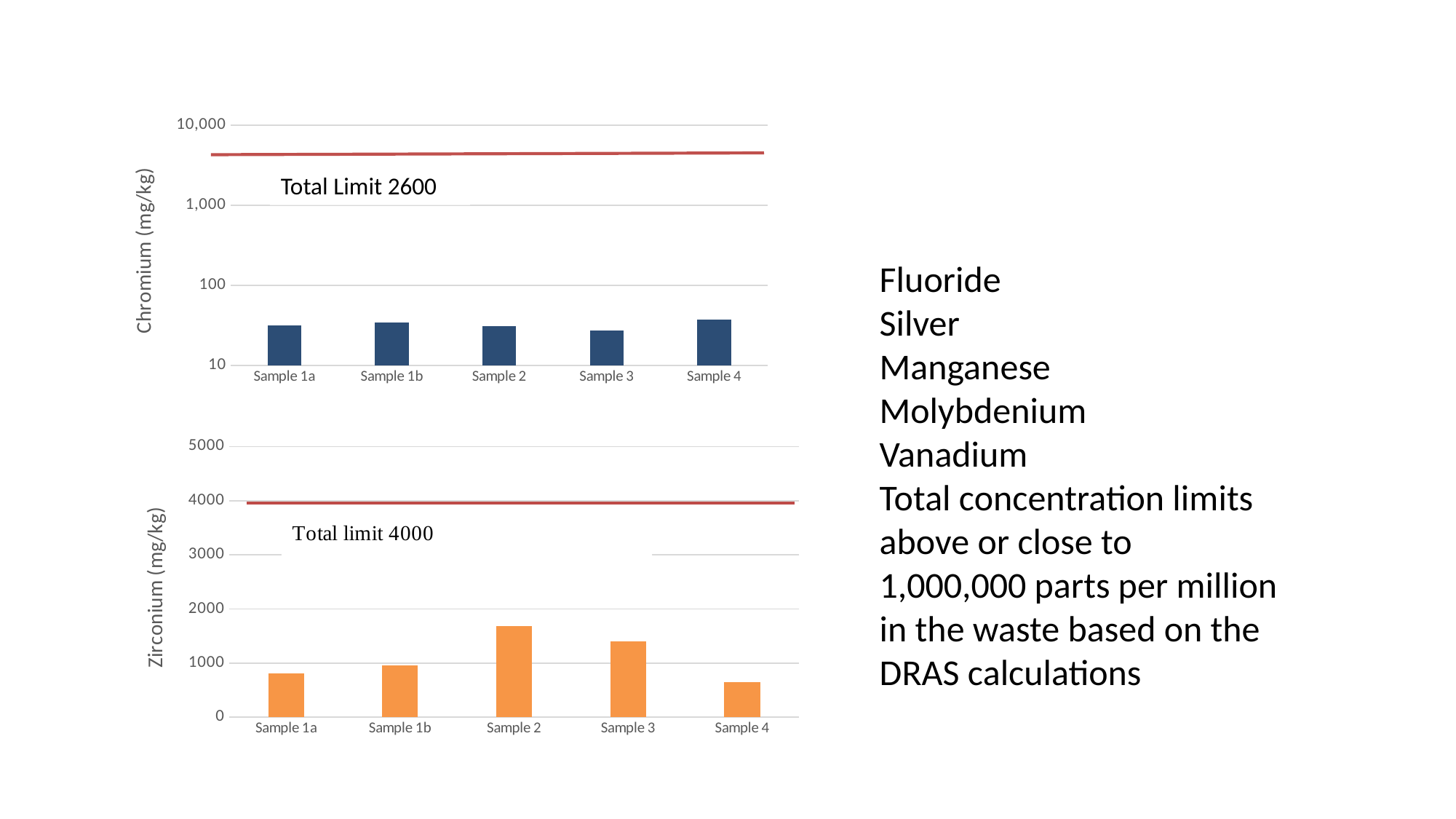
In the Zirconium (mg/kg) chart at the bottom, is the value for Sample 4 greater or less than 1000? less What total limit is labelled on the Chromium (mg/kg) chart at the top? Total Limit 2600 What kind of chart is the Zirconium (mg/kg) chart at the bottom? bar chart What total limit is labelled on the Zirconium (mg/kg) chart at the bottom? Total limit 4000 In the Zirconium (mg/kg) chart at the bottom, which is larger, Sample 2 or Sample 3? Sample 2 In the Chromium (mg/kg) chart at the top, is the value for Sample 4 greater or less than 100? less In the Zirconium (mg/kg) chart at the bottom, is the value for Sample 3 greater or less than 1000? greater In the Zirconium (mg/kg) chart at the bottom, which sample has the highest value? Sample 2 In the Chromium (mg/kg) chart at the top, how many samples are plotted? 5 In the Zirconium (mg/kg) chart at the bottom, which sample has the lowest value? Sample 4 In the Zirconium (mg/kg) chart at the bottom, which is larger, Sample 1b or Sample 4? Sample 1b